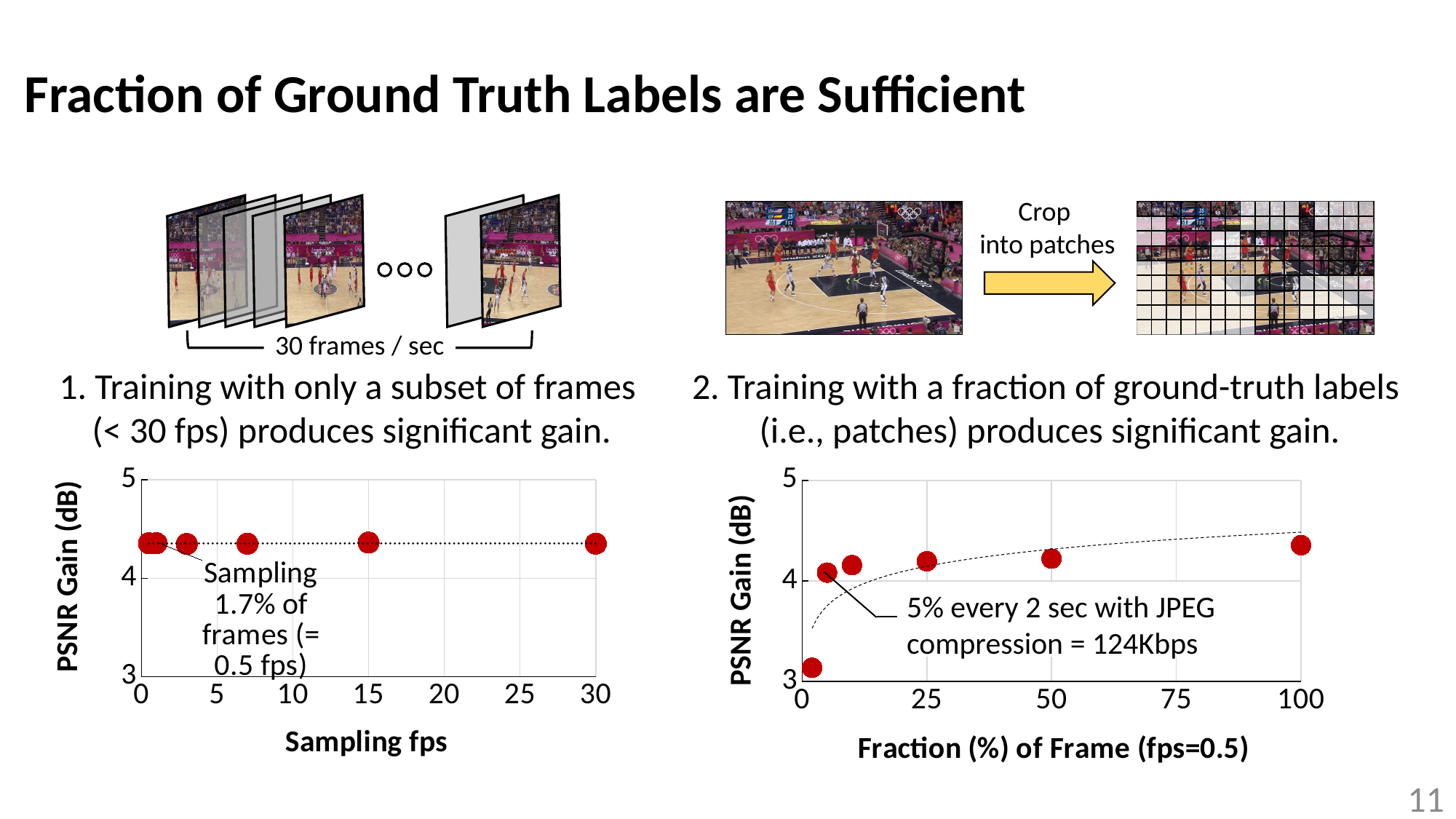
In the left chart (Sampling fps), how many data points are plotted? 6 In the left chart (Sampling fps), is the PSNR gain at 30 fps greater or less than 4? greater In the left chart (Sampling fps), do the PSNR gain values rise, fall, or stay roughly flat as sampling fps increases? stay roughly flat What kind of chart is the right chart with x-axis 'Fraction (%) of Frame (fps=0.5)'? scatter chart In the right chart (Fraction (%) of Frame), do the PSNR gain values generally rise or fall as the fraction increases? rise In the right chart (Fraction (%) of Frame), how many data points are plotted? 6 In the right chart (Fraction (%) of Frame), is the PSNR gain at the smallest fraction (leftmost point) greater or less than 4? less In the right chart (Fraction (%) of Frame), is the PSNR gain at 100% greater or less than 4? greater What kind of chart is the left chart with x-axis 'Sampling fps'? scatter chart In the right chart (Fraction (%) of Frame), which has a larger PSNR gain: the point at 5% or the point at 100%? 100% In the right chart (Fraction (%) of Frame), which point has the lowest PSNR gain? the leftmost point (smallest fraction) What is the y-axis title of the left chart? PSNR Gain (dB)